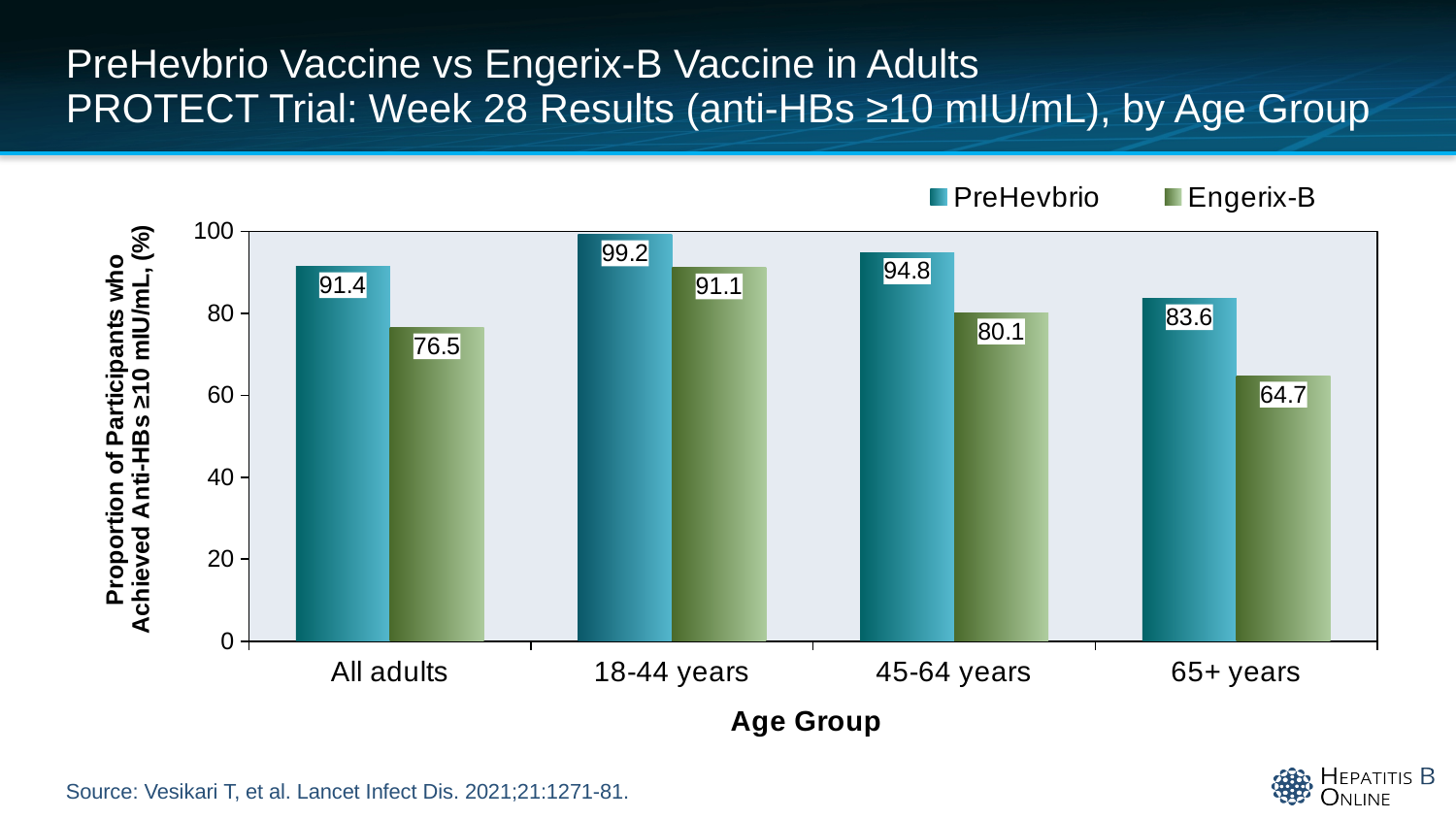
How many age group categories are shown on the x axis? 4 What is the difference between the PreHevbrio and Engerix-B values in the 65+ years group? 18.9 What is the value for PreHevbrio in the All adults group? 91.4 Which is larger in the 45-64 years group, PreHevbrio or Engerix-B? PreHevbrio Which age group has the highest PreHevbrio value? 18-44 years Which age group has the lowest Engerix-B value? 65+ years What is the value for Engerix-B in the 45-64 years group? 80.1 How many series does the legend list? 2 What kind of chart is shown on the slide? Bar chart What is the label of the x axis? Age Group What is the difference between the PreHevbrio and Engerix-B values in the 18-44 years group? 8.1 What is the value for Engerix-B in the 65+ years group? 64.7